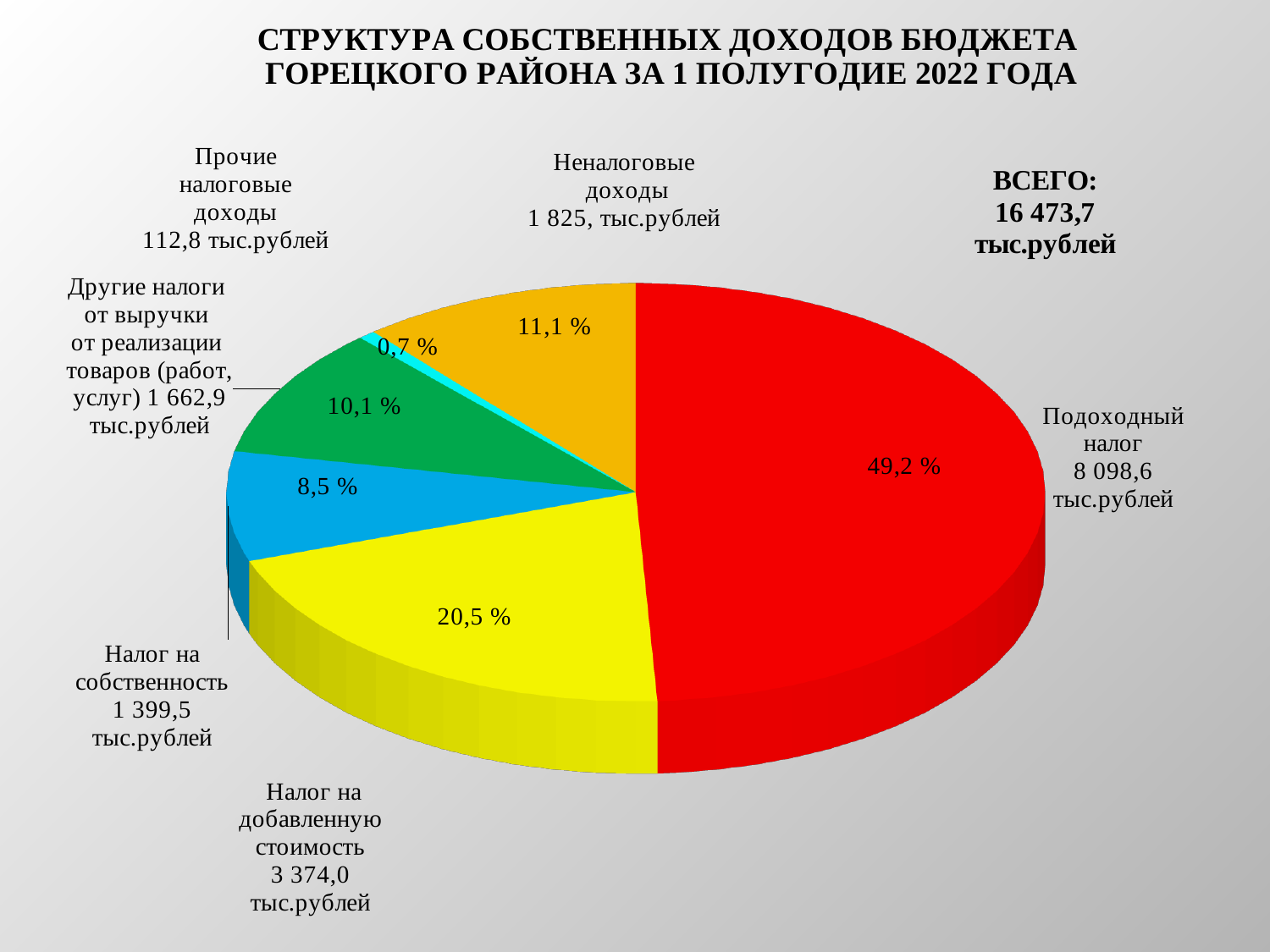
What total (ВСЕГО) is shown on the slide? 16 473,7 тыс.рублей What percentage is shown for Прочие налоговые доходы? 0,7 % What share of the pie does Подоходный налог have? 49,2 % What kind of chart is shown on the slide? pie chart What is the difference in percentage points between Подоходный налог (49,2 %) and Налог на добавленную стоимость (20,5 %)? 28,7 % How many slices does the pie chart have? 6 What is the value shown for Другие налоги от выручки от реализации товаров (работ, услуг)? 1 662,9 тыс.рублей What share of the pie does Налог на добавленную стоимость have? 20,5 % Which is larger: the share for Неналоговые доходы or the share for Налог на собственность? Неналоговые доходы Which category has the largest slice of the pie? Подоходный налог Which category has the smallest slice of the pie? Прочие налоговые доходы What is the value shown for Налог на собственность? 1 399,5 тыс.рублей